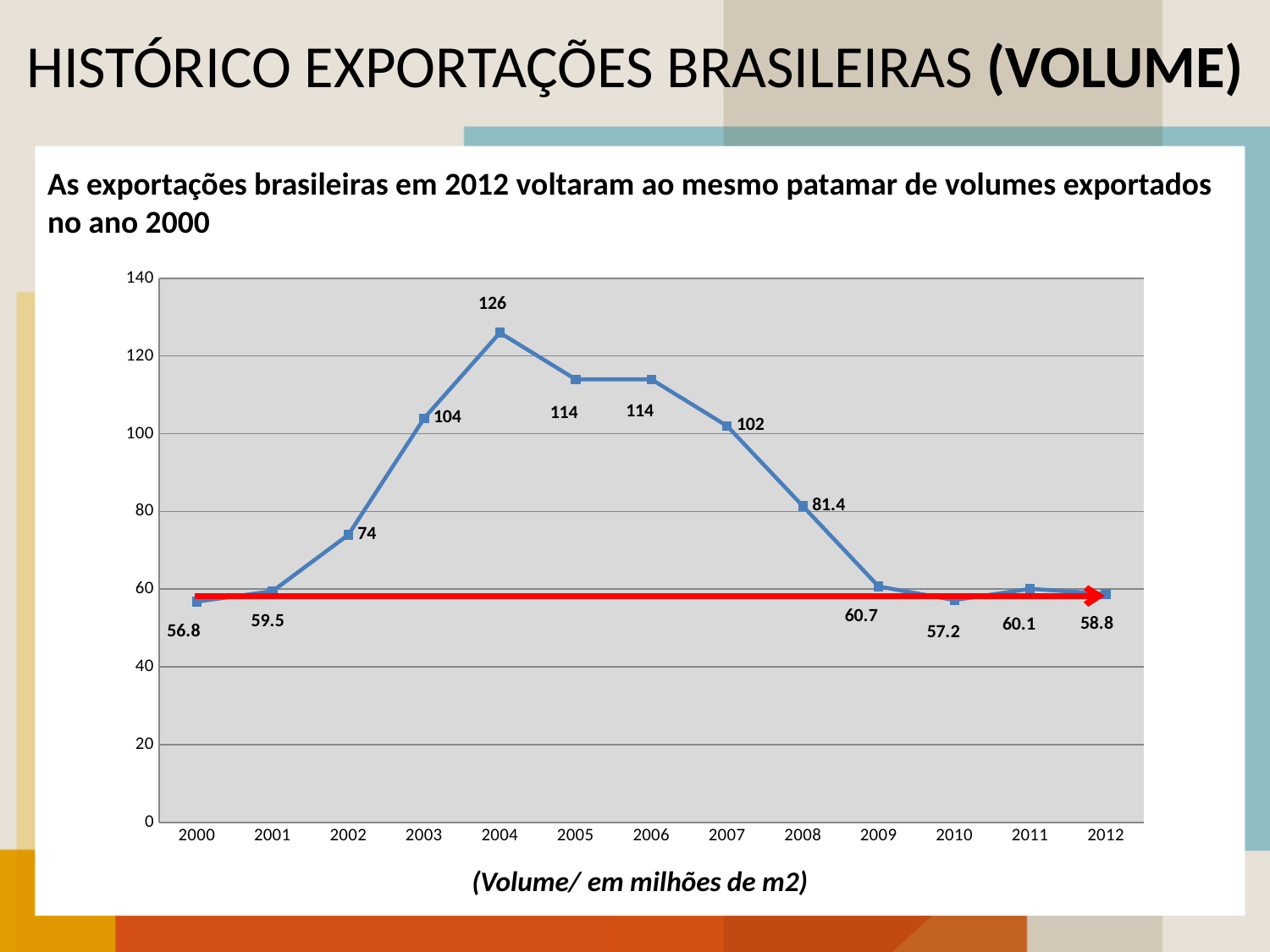
What is the difference between the export volume in 2004 and in 2012? 67.2 What unit is given below the chart for the plotted volumes? milhões de m2 What is the export volume value for 2008? 81.4 Which year has a larger export volume, 2003 or 2007? 2003 What kind of chart is shown on the slide? line chart What is the export volume value for 2004? 126 What is the export volume value for 2012? 58.8 Which year has the highest export volume? 2004 Which year has the lowest export volume? 2000 What is the export volume value for 2000? 56.8 Do the export volumes rise or fall from 2004 to 2010? fall How many years are plotted on the x axis? 13